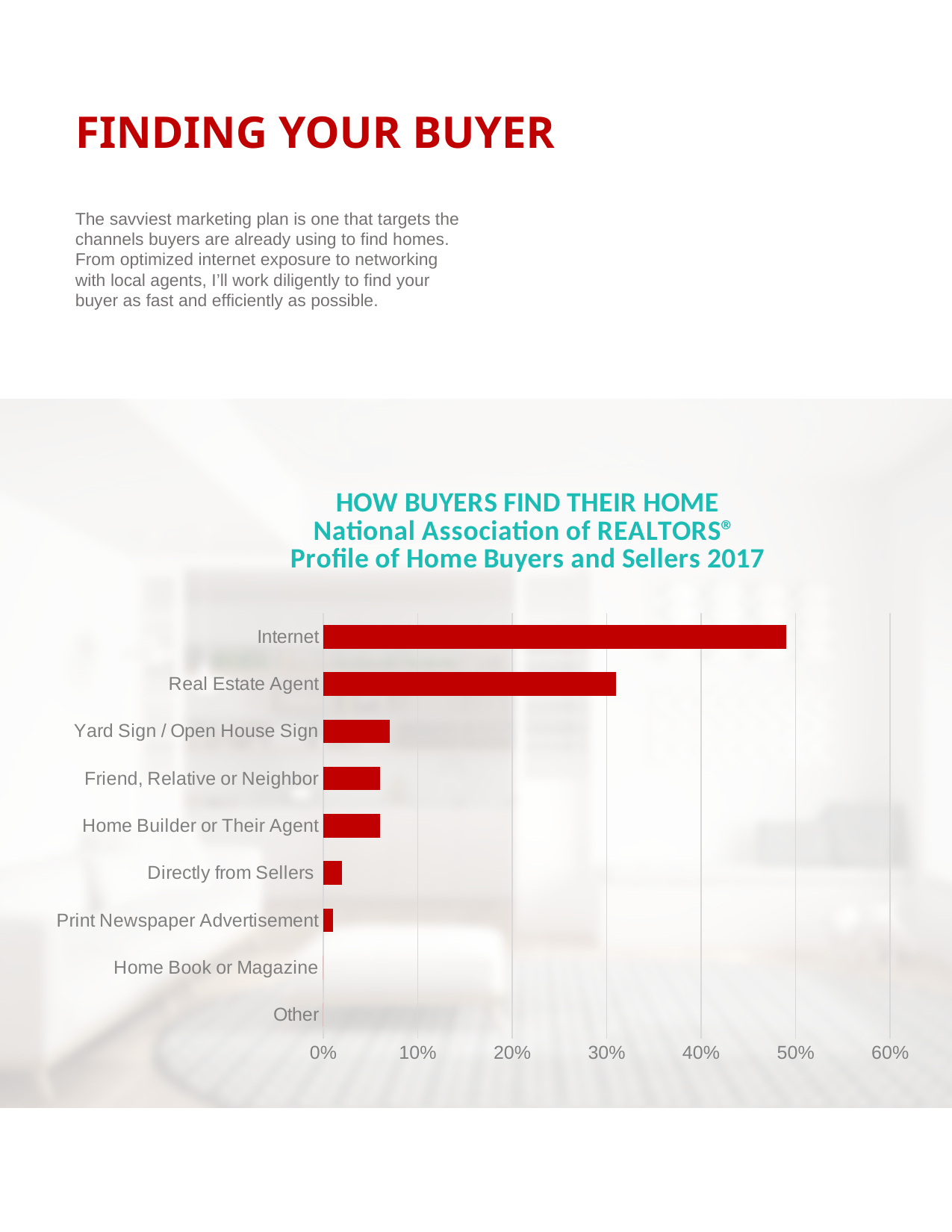
Is the value for Real Estate Agent greater or less than 20%? greater What colour are the bars in the chart? red Which category has the highest value in the chart? Internet Is the value for Internet greater or less than 40%? greater What kind of chart is shown on the slide? bar chart Is the value for Yard Sign / Open House Sign greater or less than 10%? less What is the first line of the chart's title? HOW BUYERS FIND THEIR HOME How many categories are plotted in the chart? 9 Which is larger, the value for Yard Sign / Open House Sign or the value for Print Newspaper Advertisement? Yard Sign / Open House Sign Which is larger, the value for Real Estate Agent or the value for Friend, Relative or Neighbor? Real Estate Agent Which is larger, the value for Internet or the value for Real Estate Agent? Internet